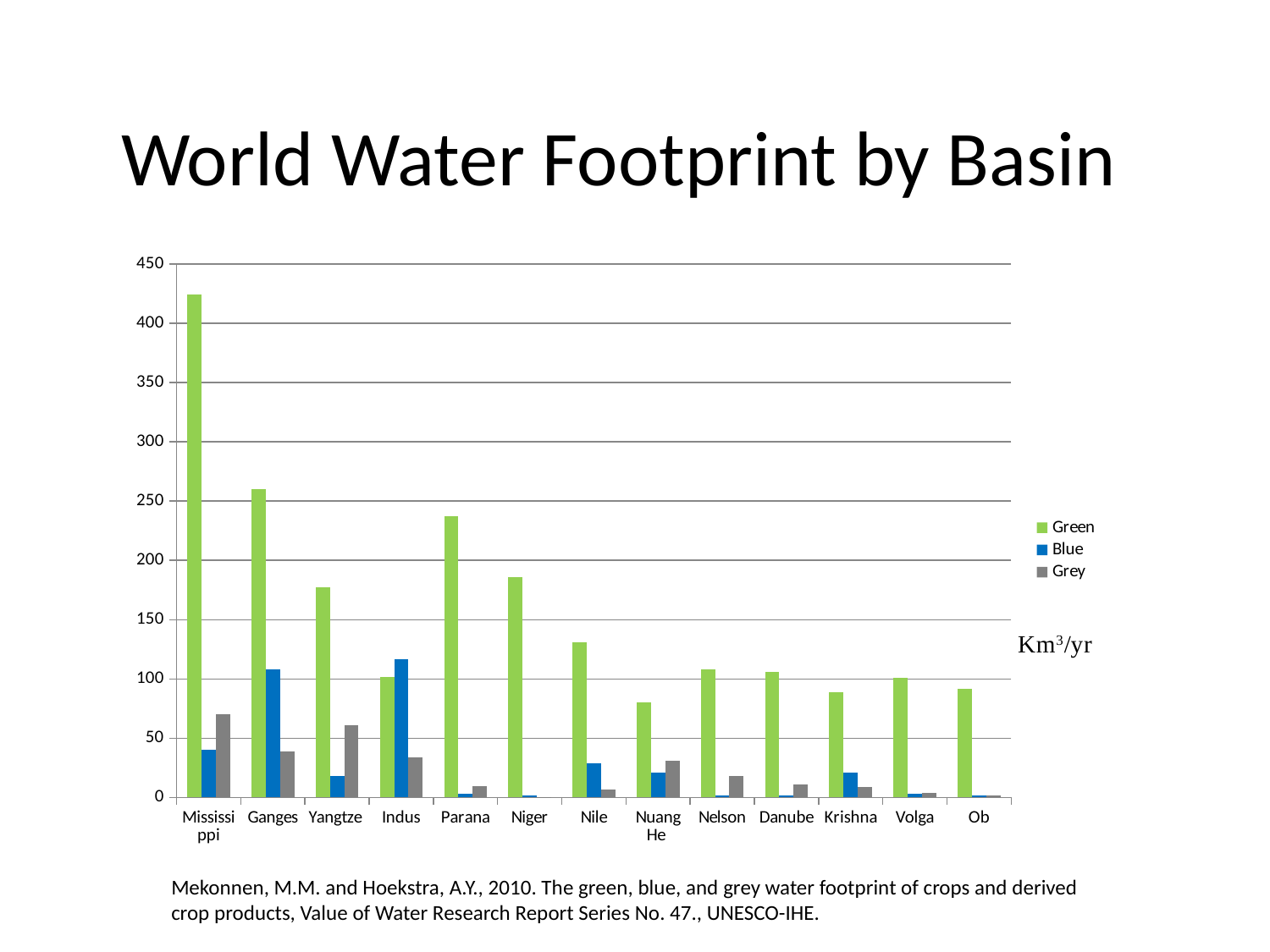
Which basin has the highest Green water footprint? Mississippi Is the Green value for Mississippi greater or less than 400? greater What unit is shown next to the legend? Km³/yr Is the Green value for Ob greater or less than 100? less What kind of chart is shown on the slide? bar chart Which basin has the highest Grey water footprint? Mississippi How many series does the legend list? 3 Which is larger, the Green value for Ganges or the Green value for Parana? Ganges How many river basins are shown on the x axis? 13 Is the Blue value for Indus greater or less than 100? greater Which basin has the highest Blue water footprint? Indus